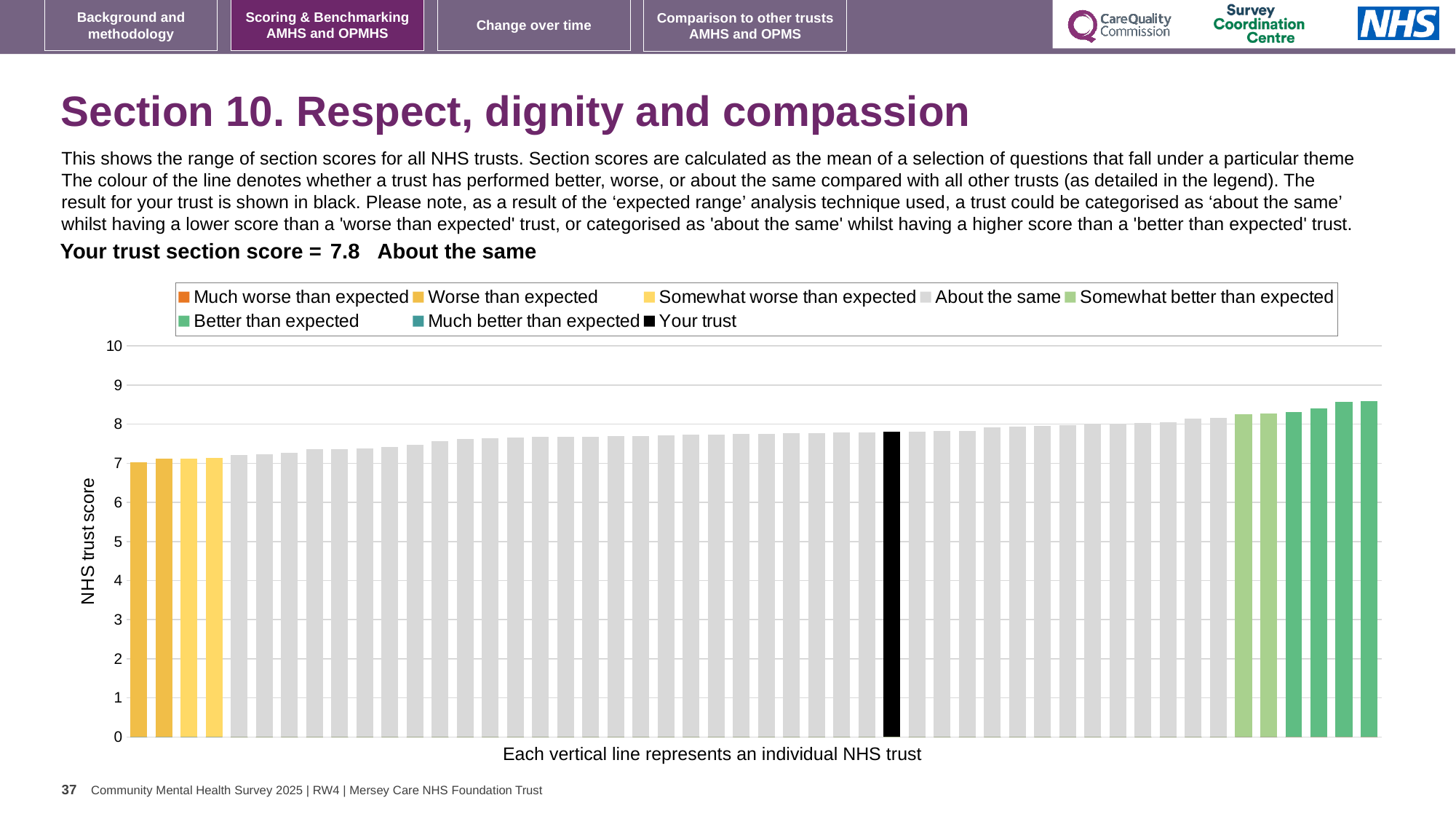
Is the value of the tallest bar on the chart greater or less than 9? less What is the label on the vertical axis of the chart? NHS trust score What kind of chart is shown on the slide? bar chart Is the value of the leftmost (shortest) bar greater or less than 8? less What is the section score for your trust shown on the slide? 7.8 Is the value of the black 'Your trust' bar greater or less than 7? greater Is the black 'Your trust' bar taller or shorter than the leftmost bar? taller What colour is used for the 'Your trust' bar in the chart? black How many entries does the chart legend list? 8 Which category is your trust placed in for this section? About the same Do the bar values rise or fall from left to right along the x axis? rise